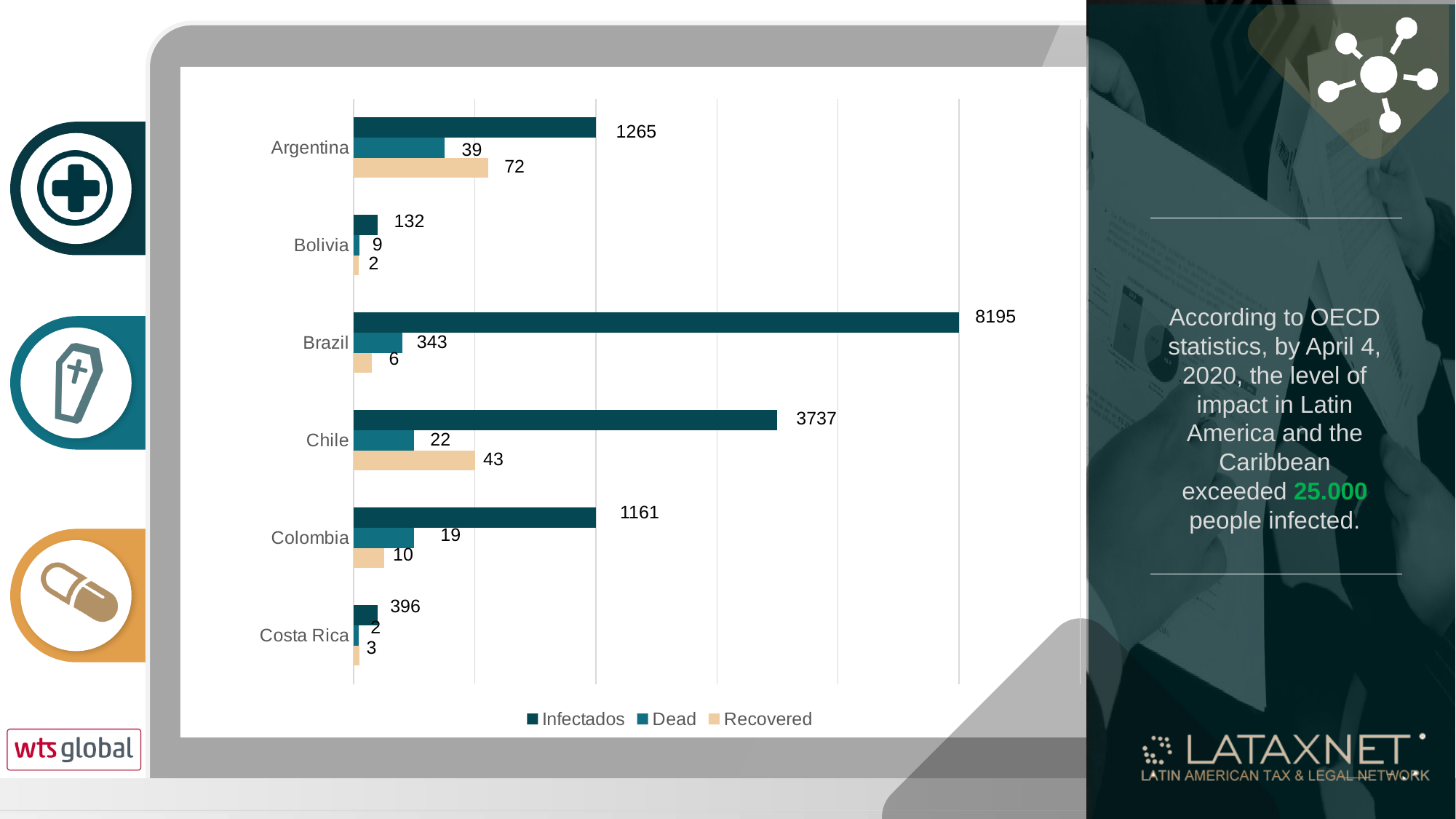
What is the Dead value for Argentina? 39 What are the three series named in the legend? Infectados, Dead, Recovered How many series does the legend list? 3 What is the difference between the Infectados values for Chile and Argentina? 2472 Which is larger, the Recovered value for Argentina or the Recovered value for Chile? Argentina Which country has the highest Infectados value? Brazil How many countries are shown on the chart? 6 What kind of chart is shown on the slide? Bar chart What is the Infectados value for Costa Rica? 396 Which country has the lowest Dead value? Costa Rica What is the Recovered value for Chile? 43 What is the Infectados value for Brazil? 8195